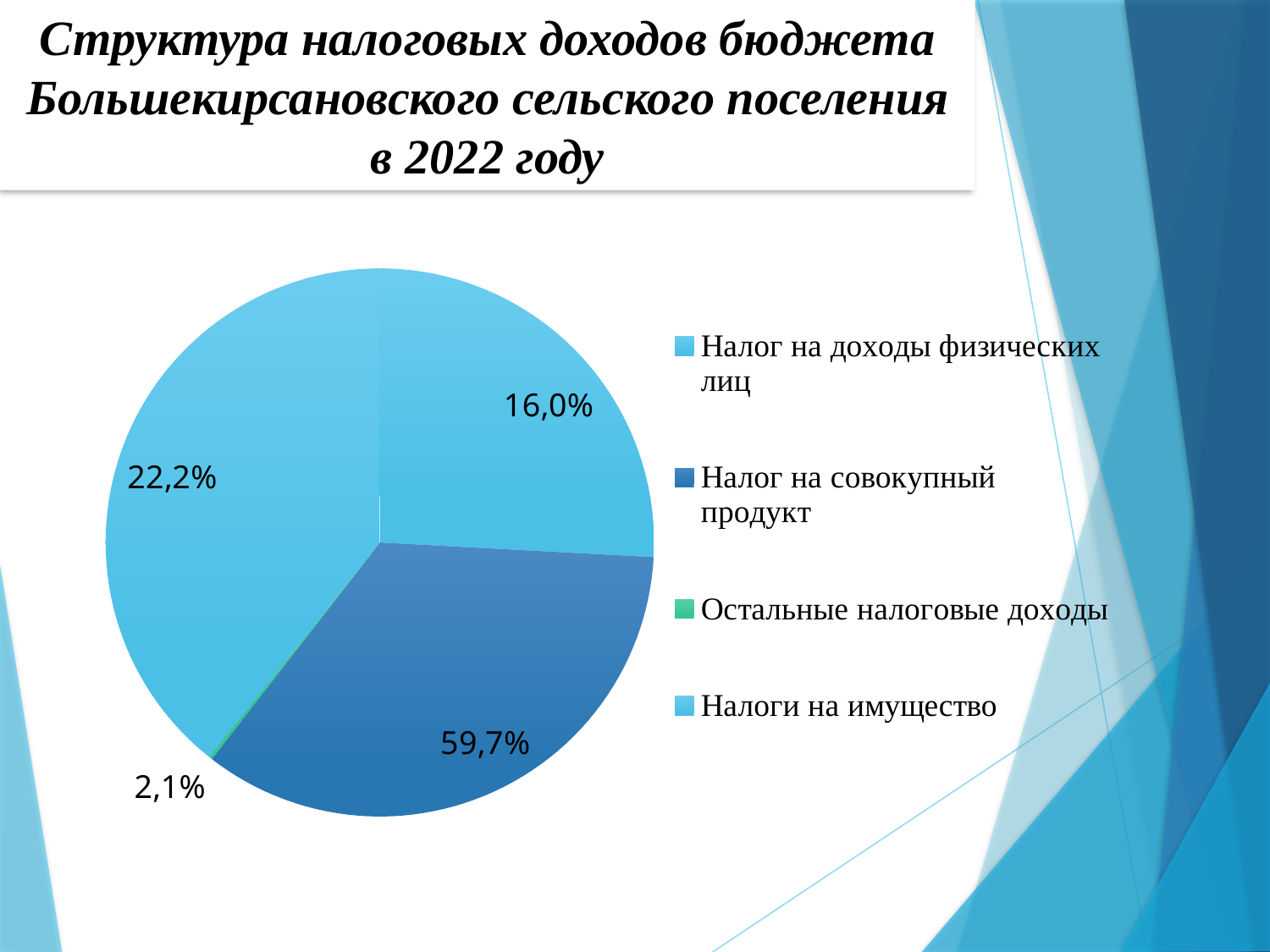
Which is larger on the pie chart: the value labelled 16,0% or the value labelled 22,2%? 22,2% What is the smallest percentage value printed on the pie chart? 2,1% What percentage is printed on the dark blue slice (Налог на совокупный продукт)? 59,7% What percentage is printed next to the green slice (Остальные налоговые доходы)? 2,1% Which year does the chart title refer to? 2022 Which legend entry is shown with a green marker? Остальные налоговые доходы How many entries does the legend of the pie chart list? 4 How many slices does the pie chart have? 4 What is the difference between the values labelled 16,0% and 2,1% on the pie chart? 13,9% What kind of chart is shown on the slide? Pie chart What is the difference between the values labelled 59,7% and 22,2% on the pie chart? 37,5% What is the largest percentage value printed on the pie chart? 59,7%